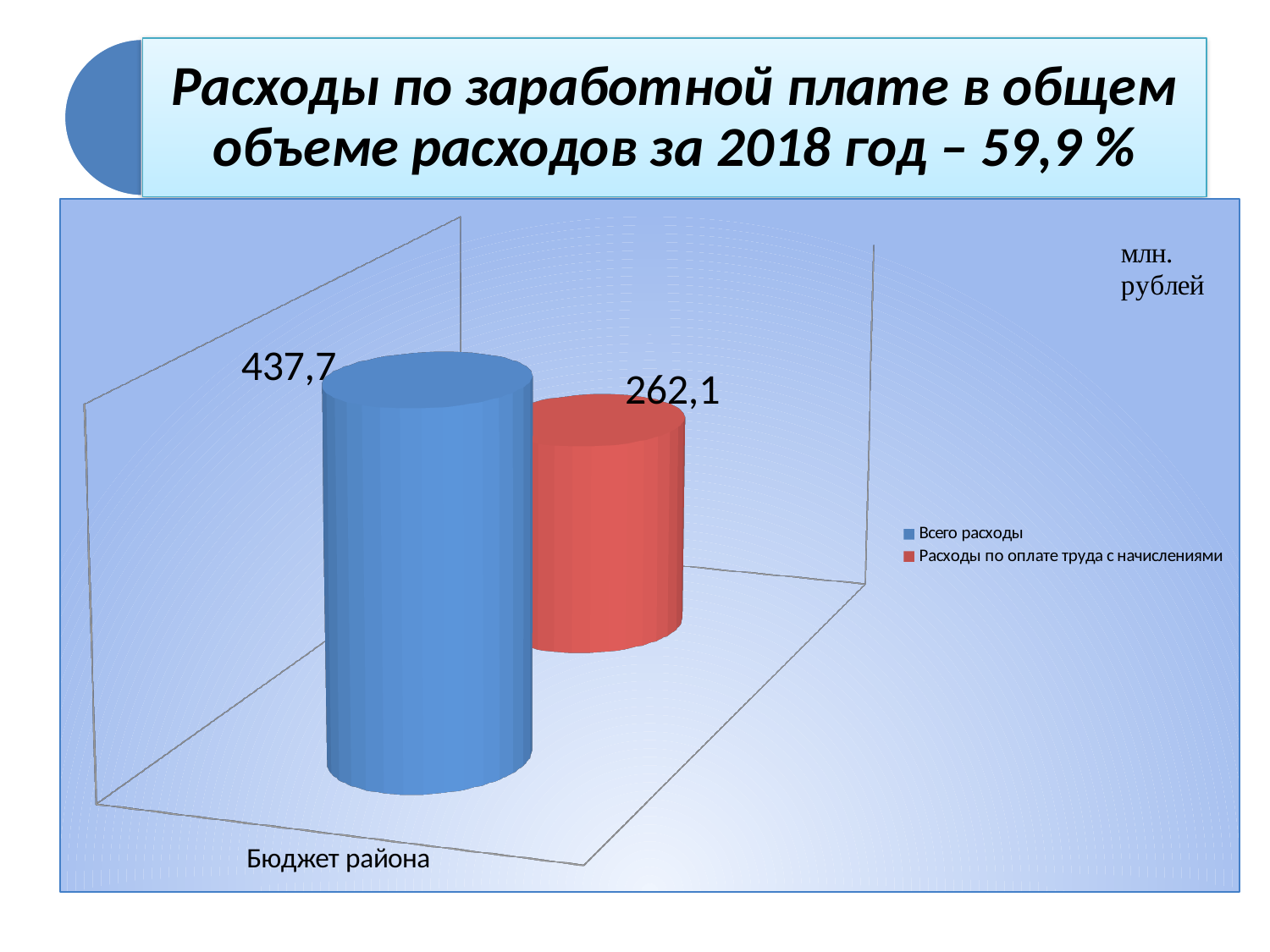
What is the difference between the values for "Всего расходы" and "Расходы по оплате труда с начислениями"? 175,6 Which series has the higher value, "Всего расходы" or "Расходы по оплате труда с начислениями"? Всего расходы Which series has the lowest value in the chart? Расходы по оплате труда с начислениями What is the value for "Всего расходы" in the chart? 437,7 What is the value for "Расходы по оплате труда с начислениями" in the chart? 262,1 What kind of chart is shown on the slide? Bar chart What is the name of the category shown on the x axis? Бюджет района How many series does the legend list? 2 How many categories are shown on the x axis of the chart? 1 What unit is indicated in the top right corner of the chart? млн. рублей Which series has the highest value in the chart? Всего расходы